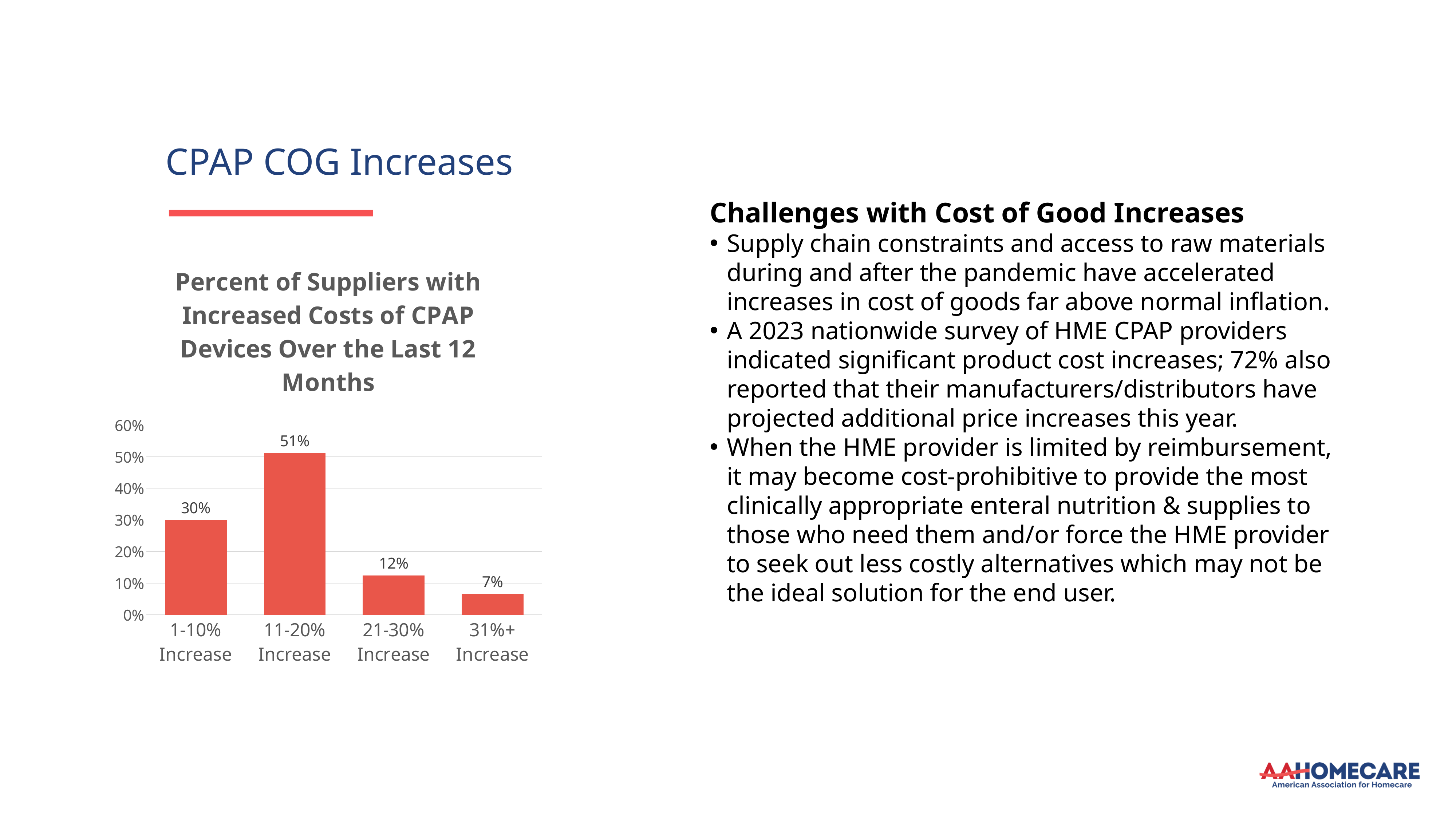
What is the title of the chart on the slide? Percent of Suppliers with Increased Costs of CPAP Devices Over the Last 12 Months Is the value for 11-20% Increase greater or less than 40%? greater What percent of suppliers reported a 1-10% increase in CPAP device costs? 30% Which cost increase category has the lowest percent of suppliers? 31%+ Increase What percent of suppliers reported a 21-30% increase in CPAP device costs? 12% How many cost increase categories are shown in the chart? 4 What percent of suppliers reported an 11-20% increase in CPAP device costs? 51% What type of chart is shown on the slide? Bar chart Which category has a larger percent of suppliers: 21-30% Increase or 31%+ Increase? 21-30% Increase Which cost increase category has the highest percent of suppliers? 11-20% Increase What percent of suppliers reported a 31%+ increase in CPAP device costs? 7% What is the difference between the percent of suppliers in the 11-20% Increase category and the 1-10% Increase category? 21%